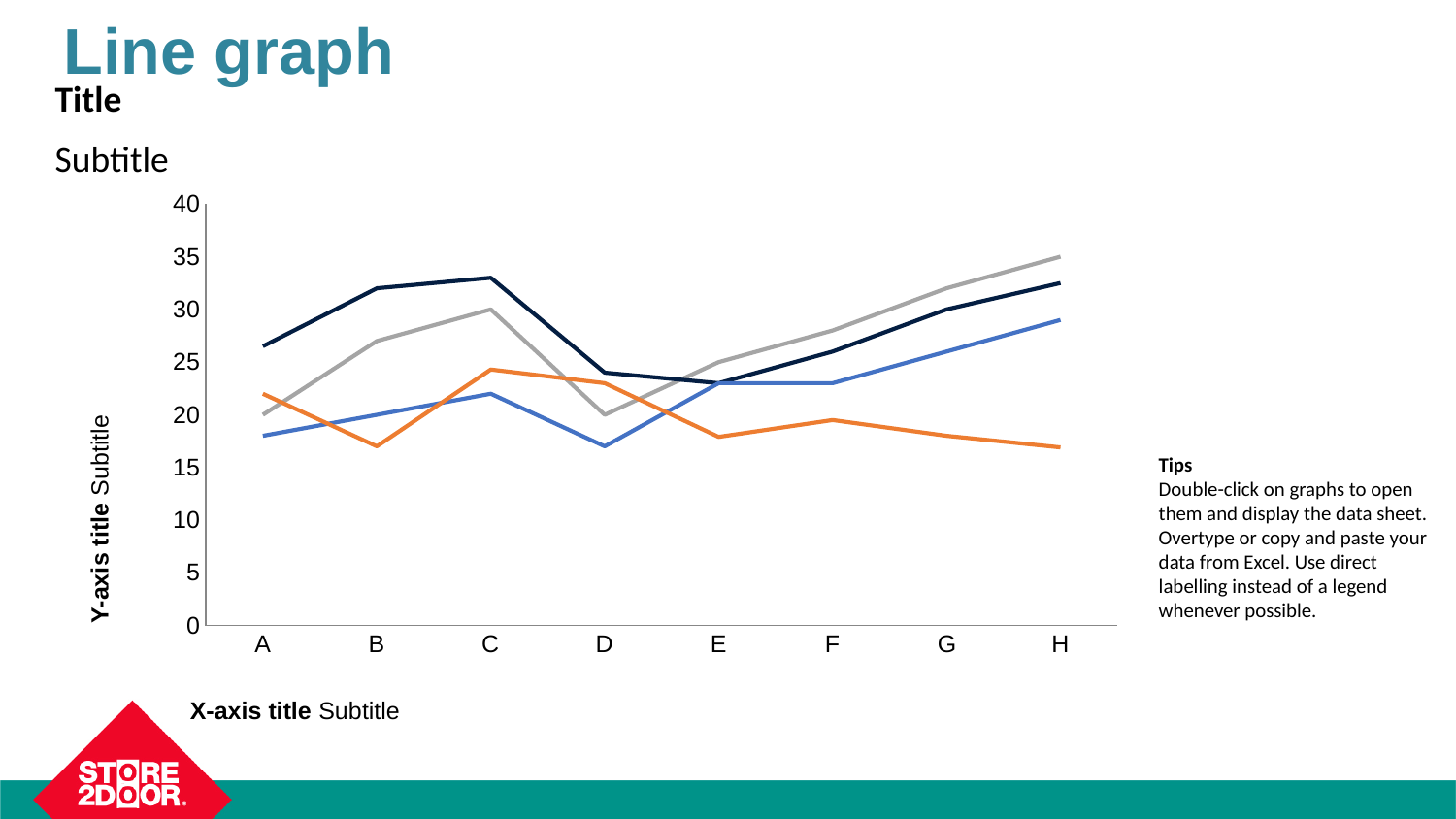
What kind of chart is shown on the slide? line chart Is the value of the grey line at H greater or less than 30? greater Is the value of the orange line at H greater or less than 20? less Is the value of the dark navy line at C greater or less than 30? greater At which category does the grey line reach its highest value? H What is the x-axis title of the chart? X-axis title Subtitle How many categories are shown on the x axis? 8 At category H, which is larger: the grey line or the orange line? the grey line At which category does the blue line reach its highest value? H How many lines are plotted on the chart? 4 Does the grey line rise or fall from D to H? rise